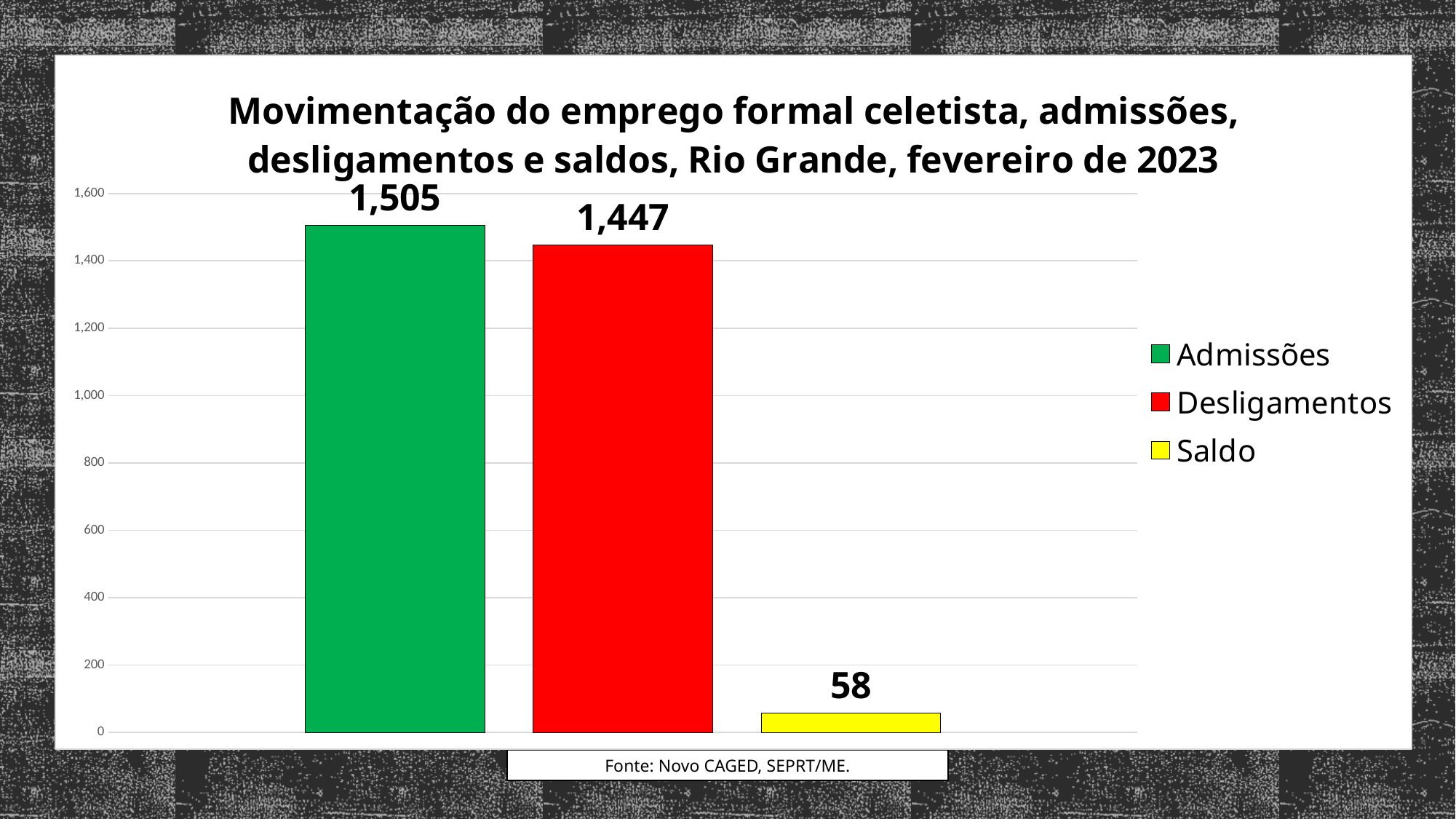
What colour is the bar for Saldo? yellow How many series does the legend list? 3 What is the value for Saldo? 58 What is the value for Desligamentos? 1,447 Which series has the highest value? Admissões What kind of chart is shown? bar chart Which is larger, Admissões or Desligamentos? Admissões Which series has the lowest value? Saldo Is the value for Saldo greater or less than 200? less Is the value for Desligamentos greater or less than 1,400? greater What is the value for Admissões? 1,505 What is the difference between Admissões and Desligamentos? 58